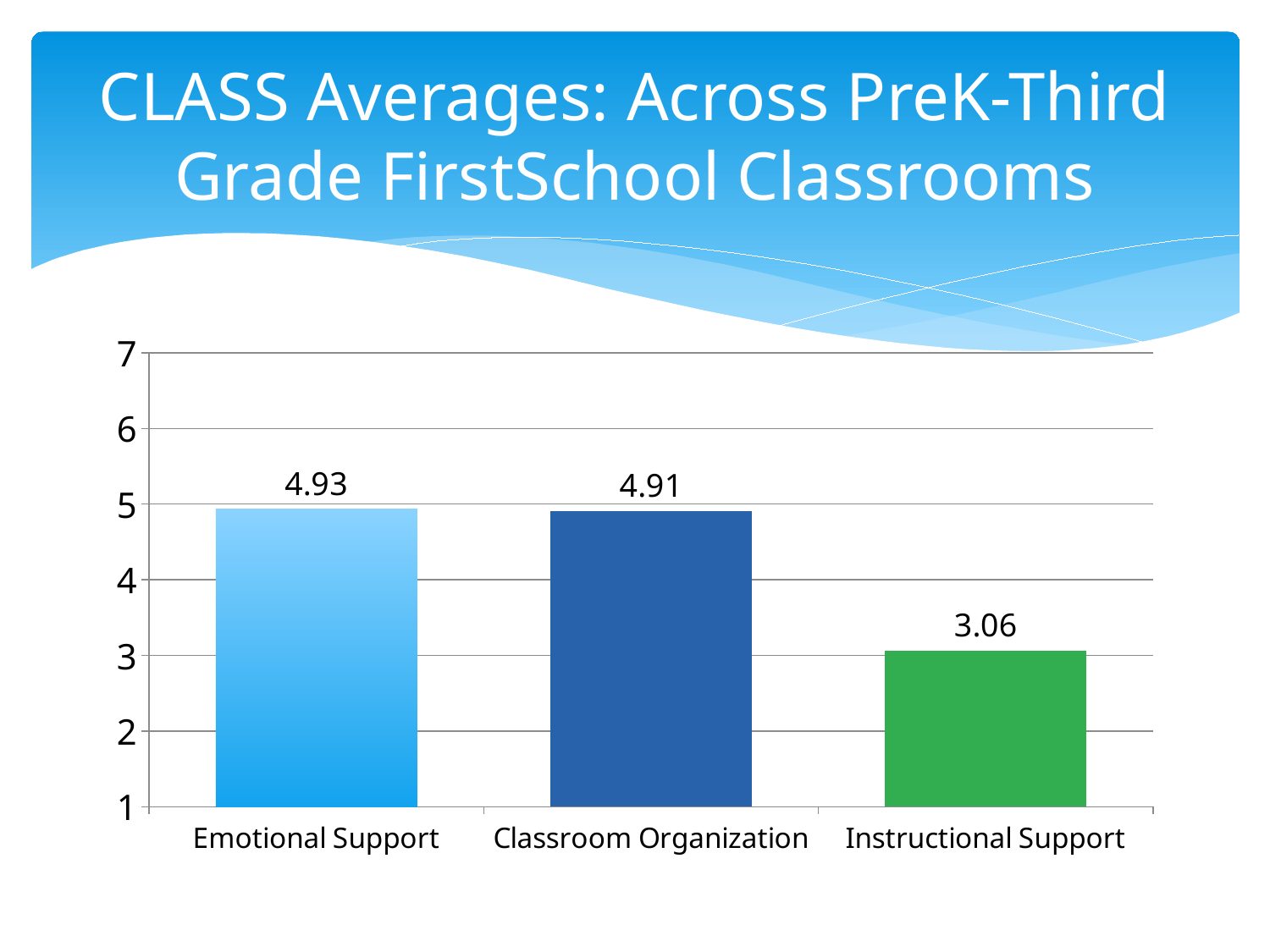
Is the value for Instructional Support greater or less than 4? less What kind of chart is shown on the slide? bar chart How many categories are shown on the x axis? 3 What is the value for Classroom Organization? 4.91 What is the difference between the values for Classroom Organization and Instructional Support? 1.85 Which is larger, the value for Classroom Organization or the value for Instructional Support? Classroom Organization Which category has the highest value? Emotional Support What colour is the bar for Instructional Support? green Which category has the lowest value? Instructional Support What is the value for Emotional Support? 4.93 What is the value for Instructional Support? 3.06 What is the difference between the values for Emotional Support and Instructional Support? 1.87